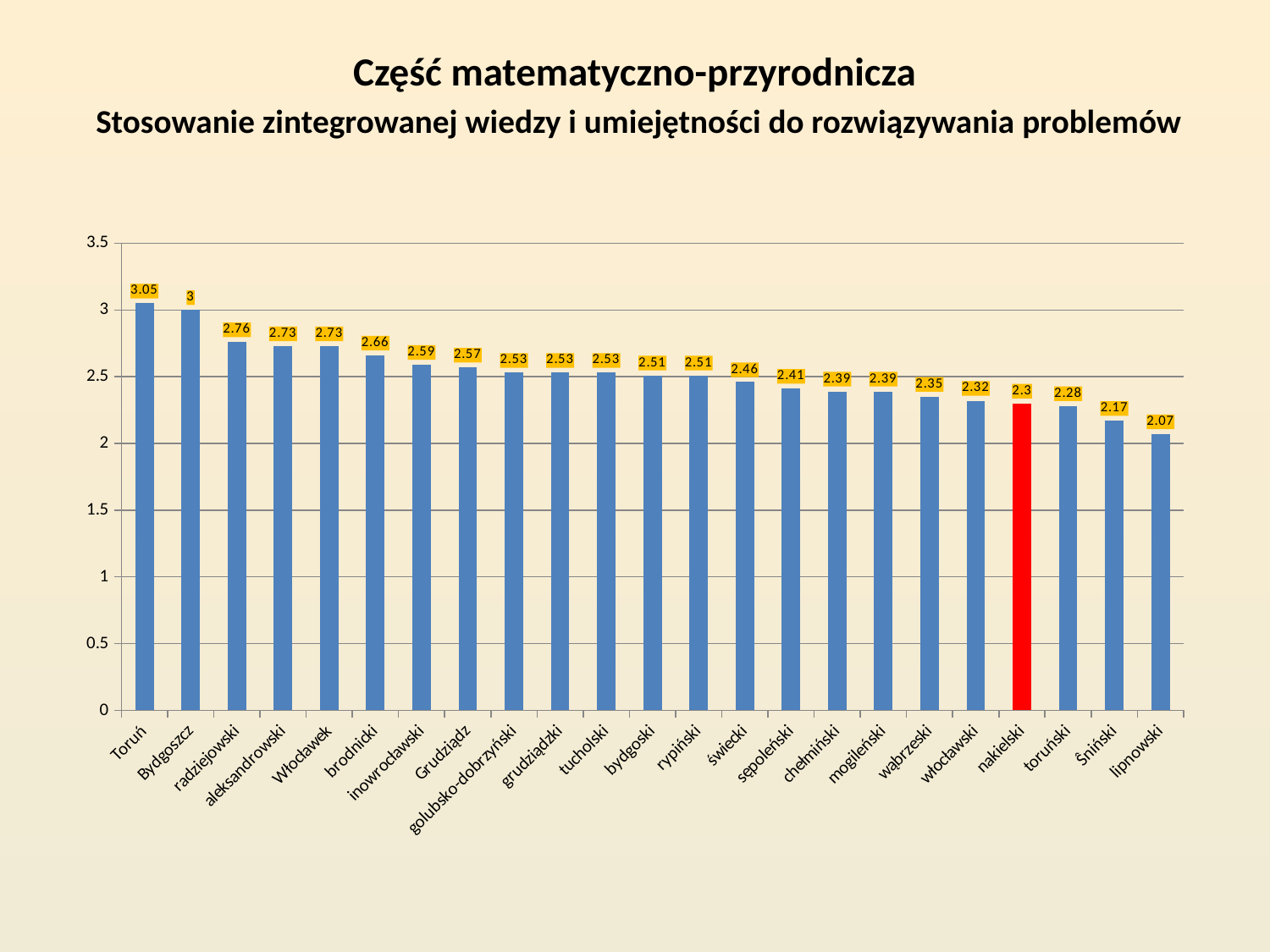
What is the difference between the values for Toruń and lipnowski? 0.98 Which category has the lowest value? lipnowski What is the value for lipnowski? 2.07 What is the value for brodnicki? 2.66 What is the value for Toruń? 3.05 Which category's bar is coloured red? nakielski Which is larger, the value for Bydgoszcz or the value for radziejowski? Bydgoszcz Is the value for świecki greater or less than 2.5? less Which category has the highest value? Toruń What kind of chart is shown on the slide? bar chart What is the value for nakielski? 2.3 How many categories are shown on the x axis? 23